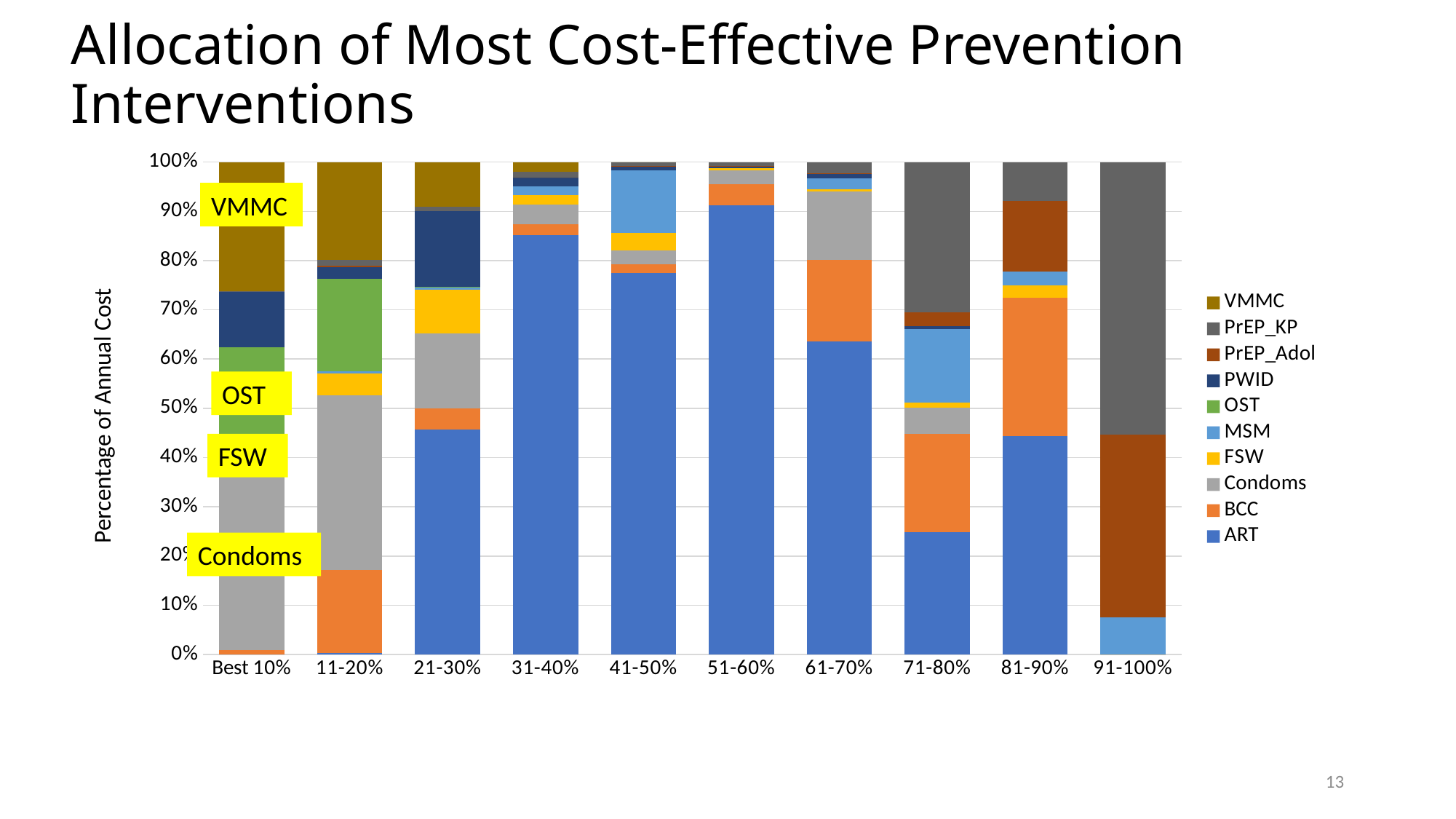
Is the ART share for 21-30% greater or less than 50%? less Does the ART share rise or fall from 21-30% to 51-60%? rise Which has a larger VMMC share, Best 10% or 11-20%? Best 10% How many series does the legend list? 10 Is the ART share for 31-40% greater or less than 80%? greater Is the ART share for 71-80% greater or less than 20%? greater Which has a larger ART share, 51-60% or 81-90%? 51-60% What kind of chart is shown on the slide? Stacked bar chart How many categories are shown along the x axis? 10 What is the title of the y axis? Percentage of Annual Cost Which category has the largest ART share? 51-60%